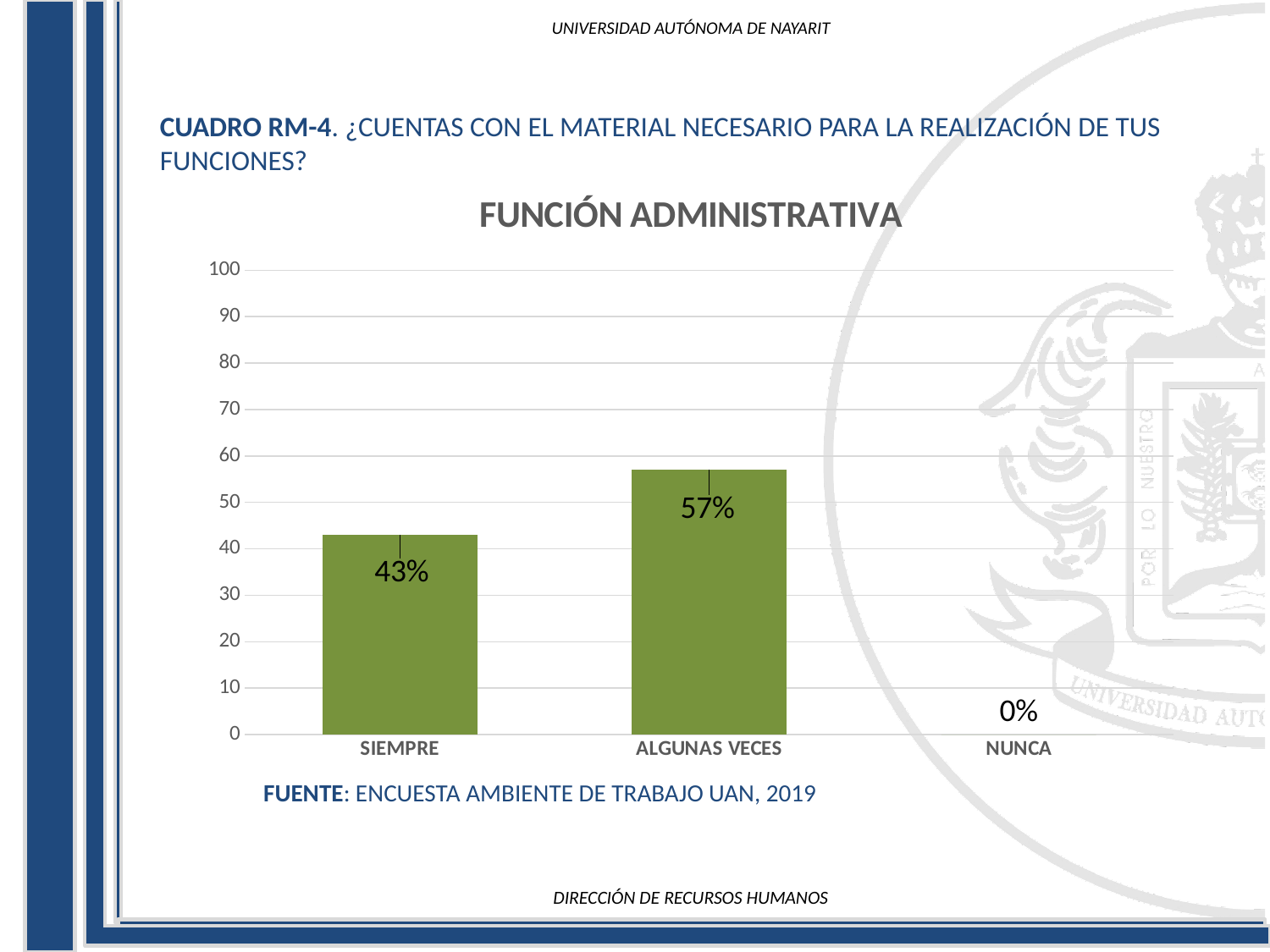
What is the maximum value shown on the y axis? 100 How many categories are shown on the x axis? 3 What is the difference between the values for ALGUNAS VECES and SIEMPRE? 14% Which category has the highest value? ALGUNAS VECES Is the value for SIEMPRE greater or less than 50? less What kind of chart is shown? bar chart Which is larger, the value for SIEMPRE or the value for ALGUNAS VECES? ALGUNAS VECES What is the value for ALGUNAS VECES? 57% What is the value for NUNCA? 0% What is the title of the chart? FUNCIÓN ADMINISTRATIVA Which category has the lowest value? NUNCA What is the value for SIEMPRE? 43%